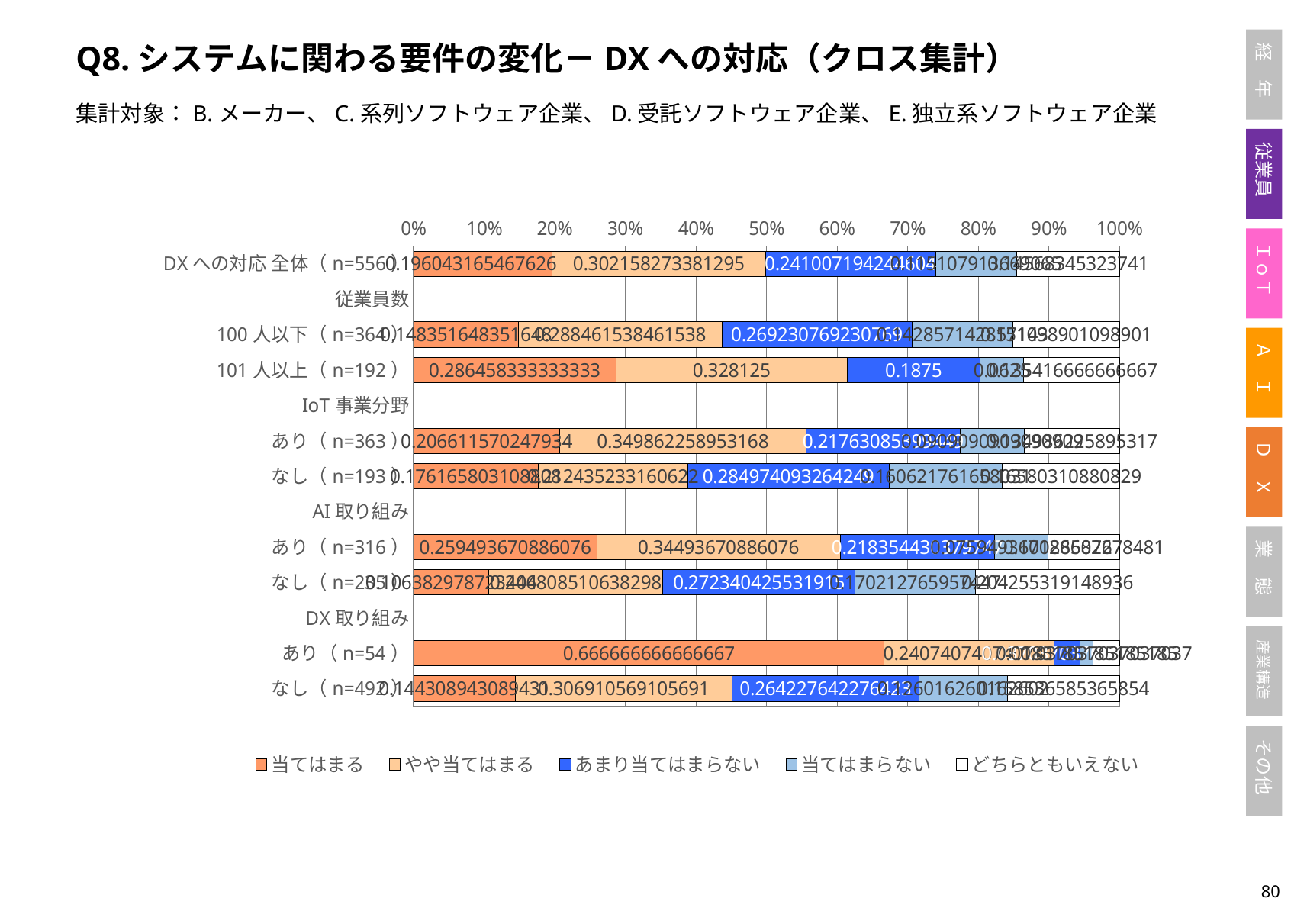
What is the value of やや当てはまる for IoT事業分野 あり（n=363）? 0.349862258953168 Is the 当てはまる value for DX取り組み あり（n=54）greater or less than 60%? greater What is the value of あまり当てはまらない for 101人以上（n=192）? 0.1875 How many series does the legend list? 5 What is the value of 当てはまる for DX取り組み あり（n=54）? 0.666666666666667 What is the value of 当てはまる for 101人以上（n=192）? 0.286458333333333 What is the value of やや当てはまる for AI取り組み あり（n=316）? 0.34493670886076 What is the difference between やや当てはまる and あまり当てはまらない for 101人以上（n=192）? 0.140625 What kind of chart is shown on the slide? bar chart What is the value of 当てはまる for AI取り組み あり（n=316）? 0.259493670886076 What is the value of やや当てはまる for 101人以上（n=192）? 0.328125 Which row has the highest value for 当てはまる? DX取り組み あり（n=54）